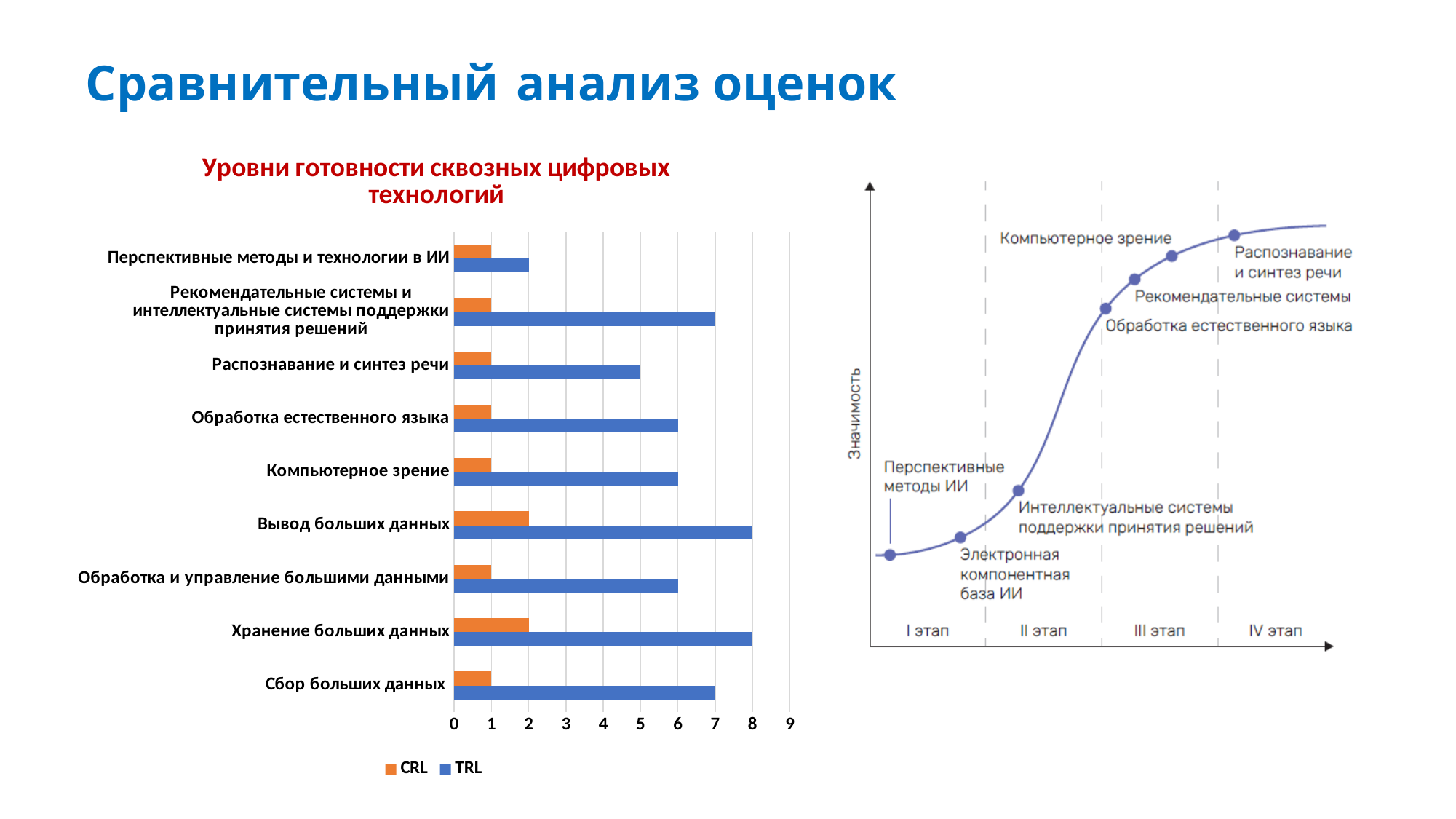
In the bar chart on the left, what is the TRL value for 'Сбор больших данных'? 7 In the bar chart on the left, is the TRL value for 'Компьютерное зрение' greater or less than 4? greater How many categories are shown in the bar chart on the left? 9 In the bar chart on the left, what is the difference between the TRL and CRL values for 'Вывод больших данных'? 6 In the bar chart on the left, which has the larger TRL value: 'Рекомендательные системы и интеллектуальные системы поддержки принятия решений' or 'Распознавание и синтез речи'? Рекомендательные системы и интеллектуальные системы поддержки принятия решений In the bar chart on the left, what is the CRL value for 'Хранение больших данных'? 2 What kind of chart is the chart on the left of the slide? Bar chart How many series does the legend of the bar chart on the left list? 2 In the bar chart on the left, which colour represents the CRL series? Orange In the bar chart titled 'Уровни готовности сквозных цифровых технологий', what is the TRL value for 'Вывод больших данных'? 8 In the bar chart on the left, what is the TRL value for 'Распознавание и синтез речи'? 5 In the bar chart on the left, which category has the lowest TRL value? Перспективные методы и технологии в ИИ